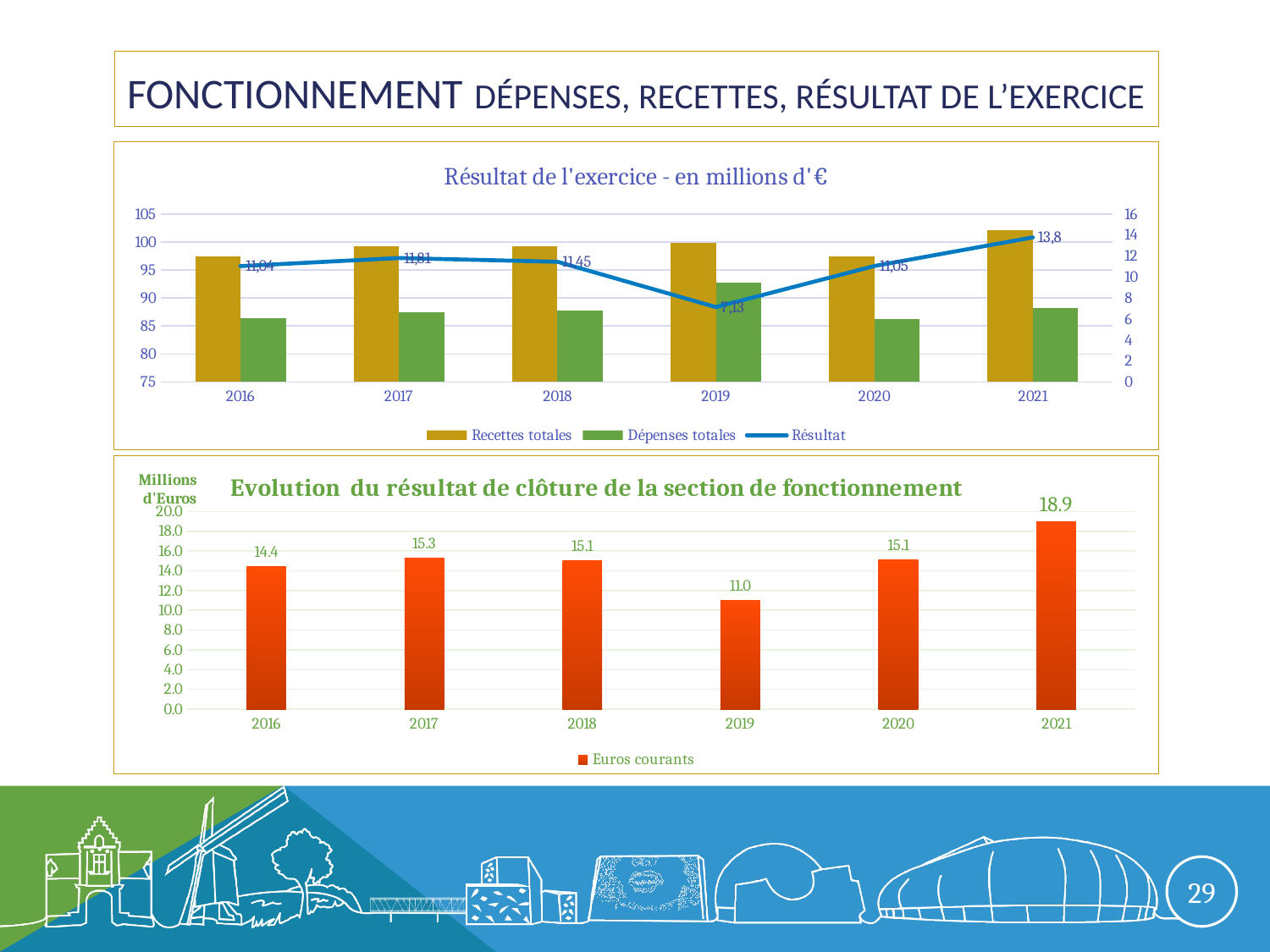
In the chart titled 'Résultat de l'exercice - en millions d'€', is the Dépenses totales value for 2019 greater or less than 90? greater In the chart titled 'Evolution du résultat de clôture de la section de fonctionnement', what is the difference between the 2021 value and the 2016 value? 4.5 In the chart titled 'Evolution du résultat de clôture de la section de fonctionnement', how many years are shown on the x axis? 6 In the chart titled 'Résultat de l'exercice - en millions d'€', which year has the lowest Résultat value? 2019 In the chart titled 'Evolution du résultat de clôture de la section de fonctionnement', which year has the highest value? 2021 What kind of chart is the bottom chart on the slide? Bar chart In the chart titled 'Evolution du résultat de clôture de la section de fonctionnement', what is the value for 2021? 18.9 In the chart titled 'Résultat de l'exercice - en millions d'€', what is the value of the Résultat line for 2019? 7,13 In the chart titled 'Résultat de l'exercice - en millions d'€', what is the value of the Résultat line for 2021? 13,8 In the chart titled 'Résultat de l'exercice - en millions d'€', how many series does the legend list? 3 In the chart titled 'Résultat de l'exercice - en millions d'€', is the Recettes totales value for 2021 greater or less than 100? greater In the chart titled 'Evolution du résultat de clôture de la section de fonctionnement', which year has the lowest value? 2019